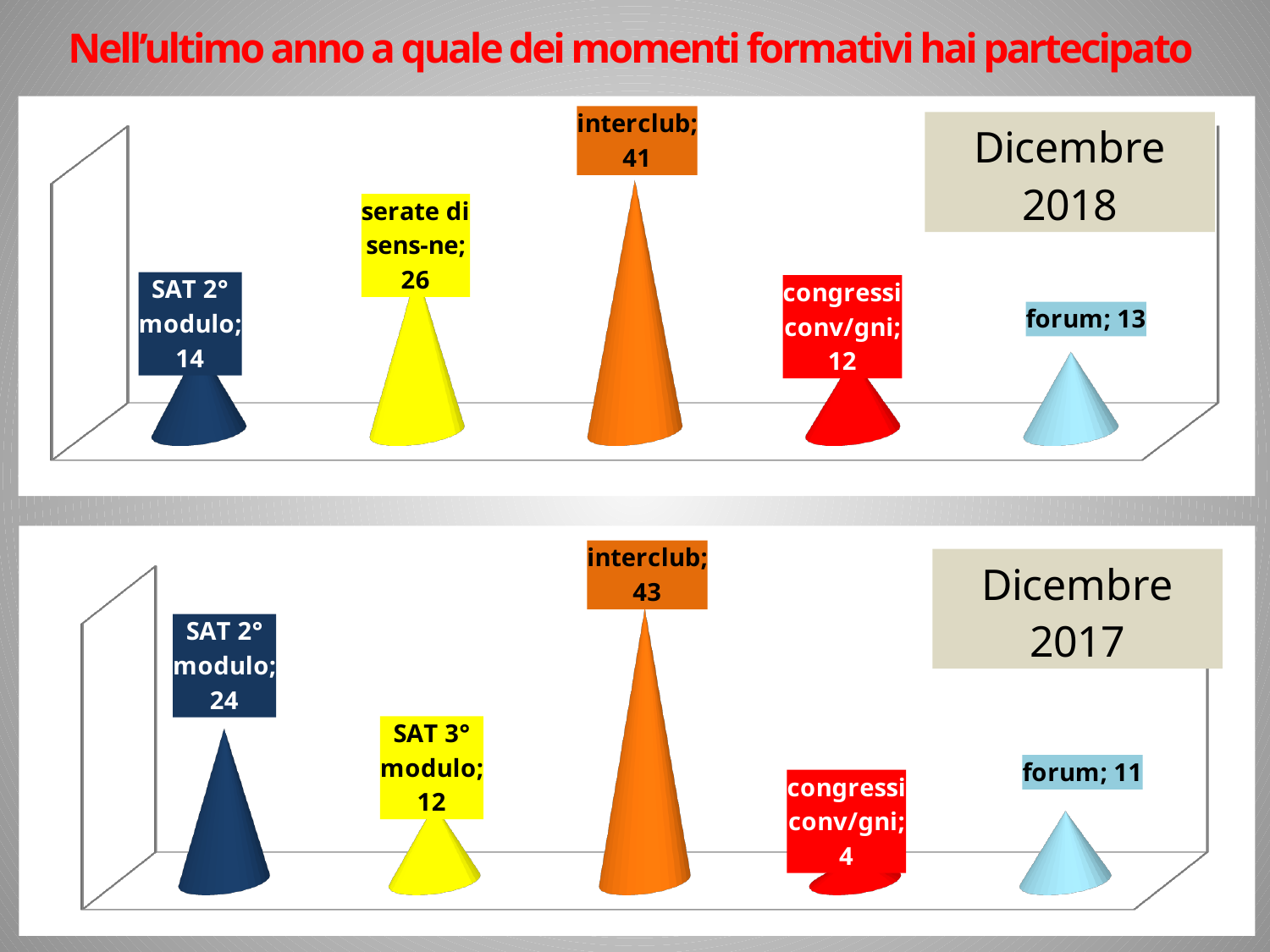
What kind of chart is the Dicembre 2017 chart? bar chart In the Dicembre 2017 chart, what is the value for SAT 2° modulo? 24 In the Dicembre 2018 chart, what is the value for serate di sens-ne? 26 In the Dicembre 2018 chart, what is the difference between interclub and serate di sens-ne? 15 In the Dicembre 2018 chart, which category has the highest value? interclub In the Dicembre 2017 chart, what is the difference between interclub and SAT 2° modulo? 19 In the Dicembre 2018 chart, what is the value for interclub? 41 How many categories are shown in the Dicembre 2018 chart? 5 In the Dicembre 2017 chart, what is the value for congressi conv/gni? 4 In the Dicembre 2017 chart, which category has the lowest value? congressi conv/gni In the Dicembre 2018 chart, which category has the lowest value? congressi conv/gni In the Dicembre 2017 chart, which is larger: SAT 2° modulo or SAT 3° modulo? SAT 2° modulo